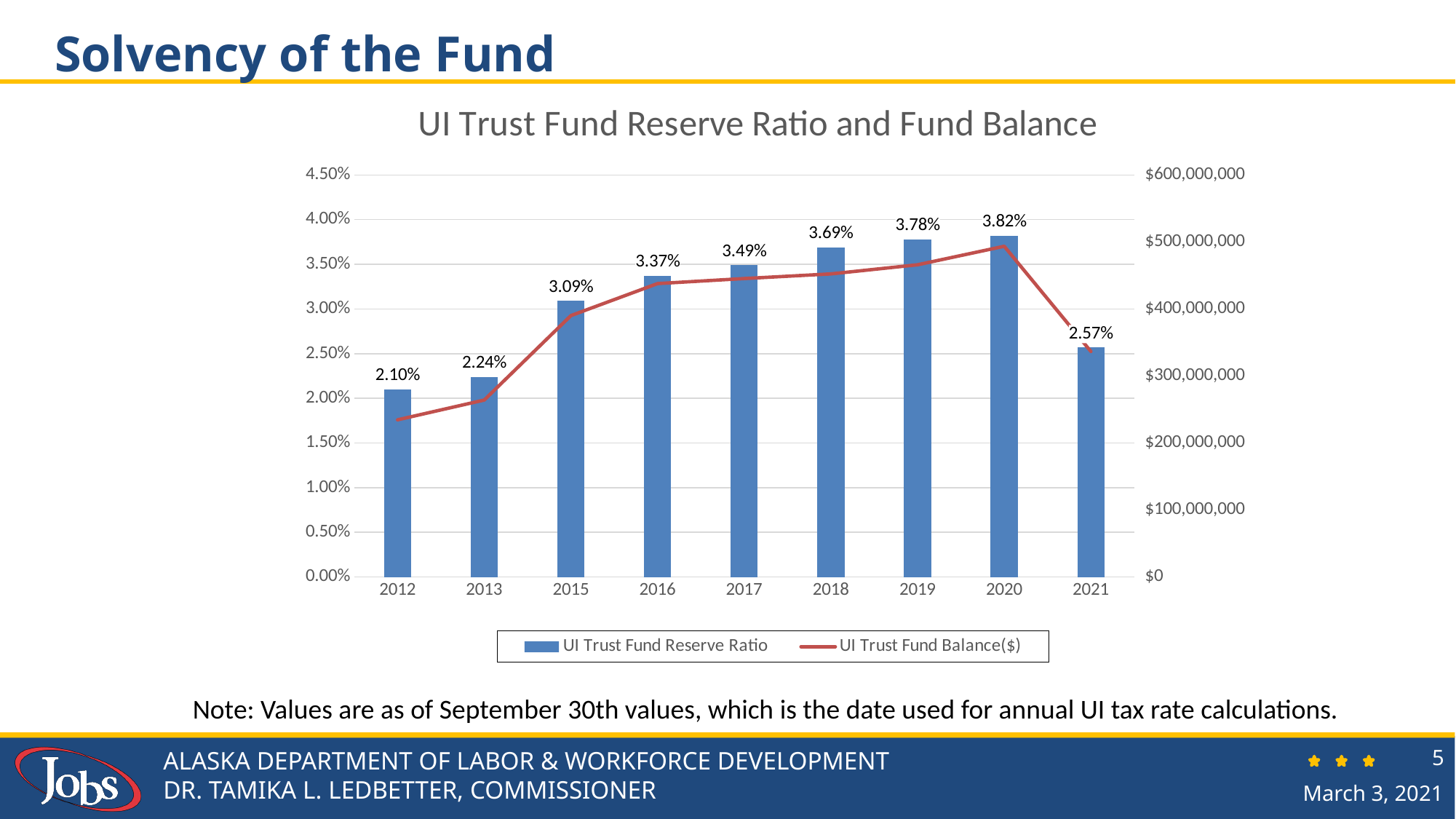
What is the difference between the UI Trust Fund Reserve Ratio in 2020 and in 2021? 1.25% What is the UI Trust Fund Reserve Ratio for 2012? 2.10% What is the title of the chart? UI Trust Fund Reserve Ratio and Fund Balance Is the UI Trust Fund Balance($) for 2020 greater or less than $400,000,000? greater How many years are shown on the x axis of the chart? 9 Is the UI Trust Fund Balance($) for 2012 greater or less than $300,000,000? less Which year has a higher UI Trust Fund Reserve Ratio, 2015 or 2018? 2018 Which year has the lowest UI Trust Fund Reserve Ratio? 2012 How many series does the chart's legend list? 2 What is the UI Trust Fund Reserve Ratio for 2021? 2.57% Which year has the highest UI Trust Fund Reserve Ratio? 2020 What is the UI Trust Fund Reserve Ratio for 2016? 3.37%